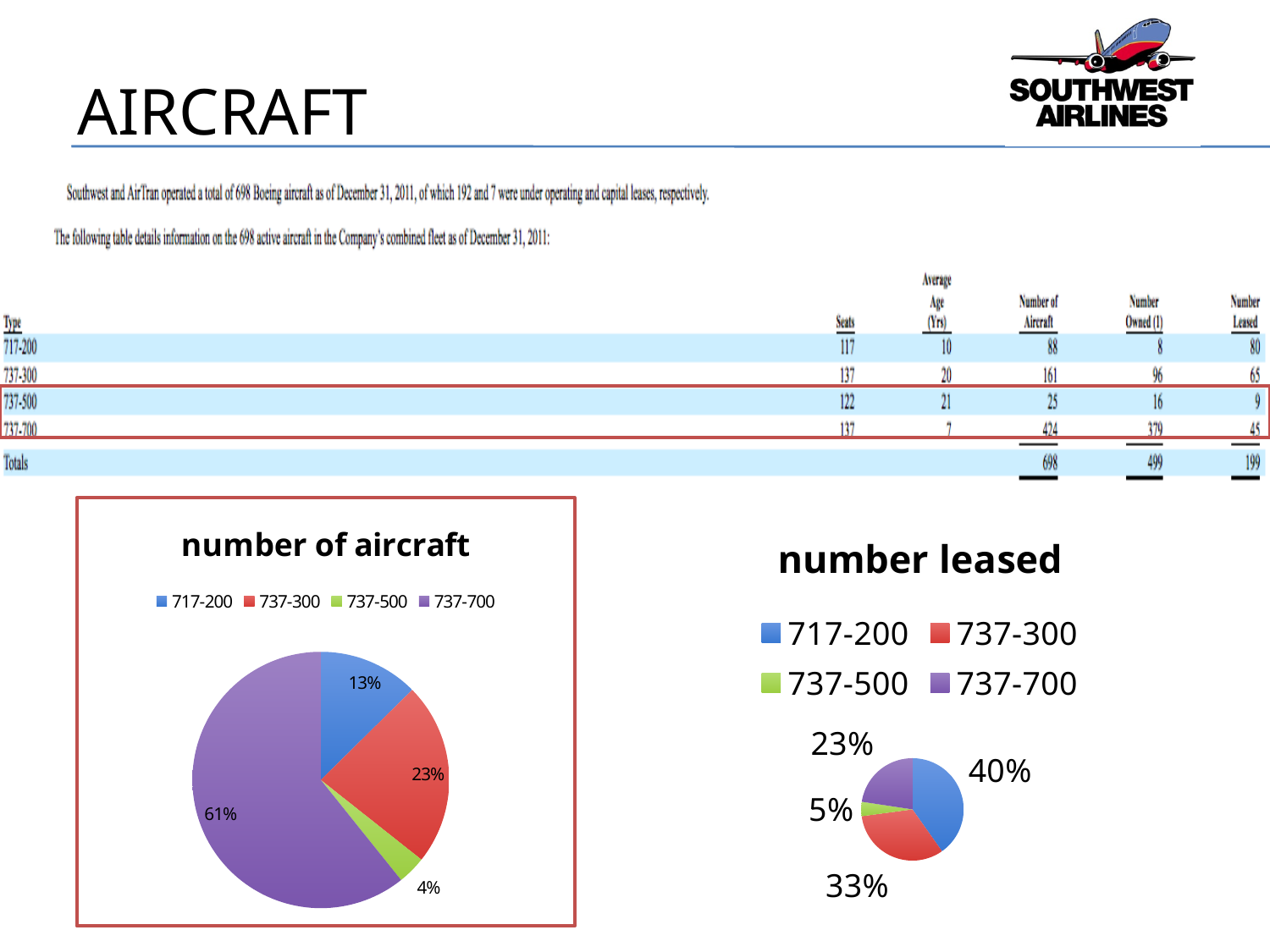
What kind of chart is the "number of aircraft" chart? Pie chart In the "number of aircraft" pie chart, what share does 717-200 have? 13% In the "number of aircraft" pie chart, what share does 737-700 have? 61% In the "number of aircraft" pie chart, which type has the smallest share? 737-500 In the "number leased" pie chart, what share does 737-700 have? 23% In the "number of aircraft" pie chart, which type has the largest share? 737-700 In the "number leased" pie chart, which type has the largest share? 717-200 In the "number leased" pie chart, which is larger, the share for 737-300 or the share for 737-700? 737-300 In the "number of aircraft" pie chart, which colour represents 737-500? Green In the "number of aircraft" pie chart, what is the difference in percentage points between 737-300 and 737-500? 19 How many series does the legend of the "number leased" chart list? 4